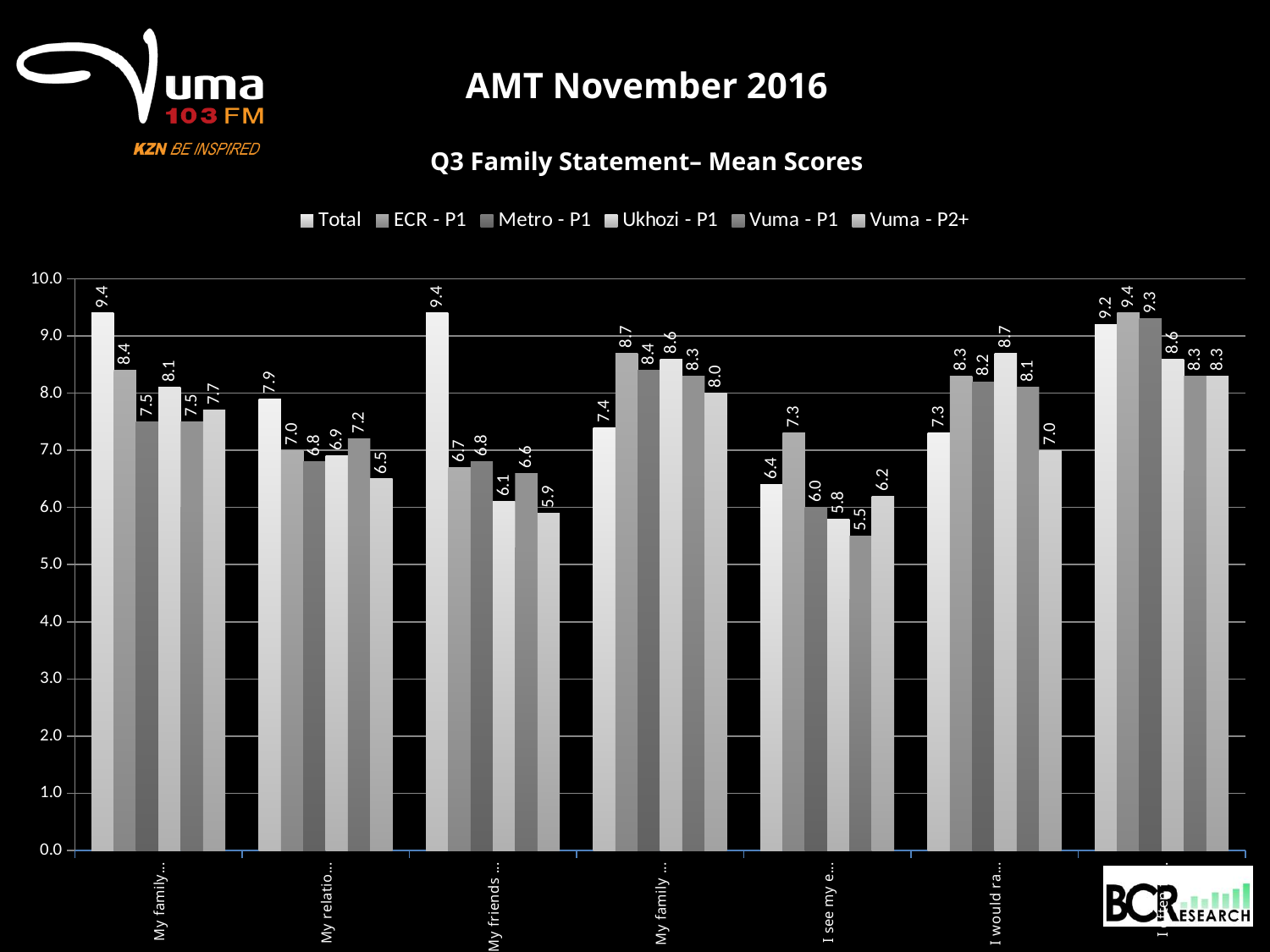
What is the ECR - P1 value for the fifth category group from the left? 7.3 What is the Vuma - P2+ value for the third category group from the left? 5.9 How many category groups are plotted along the x axis? 7 Which series has the lowest value in the fifth category group from the left? Vuma - P1 What is the Vuma - P1 value for the rightmost category group? 8.3 What kind of chart is shown on the slide? bar chart How many series does the legend list? 6 What is the chart's title? Q3 Family Statement– Mean Scores Which series has the highest value in the sixth category group from the left? Ukhozi - P1 What is the difference between the Total and Vuma - P2+ values in the third category group from the left? 3.5 What is the Total value for the first category group (leftmost)? 9.4 In the fourth category group from the left, which is larger: the Total value or the ECR - P1 value? ECR - P1